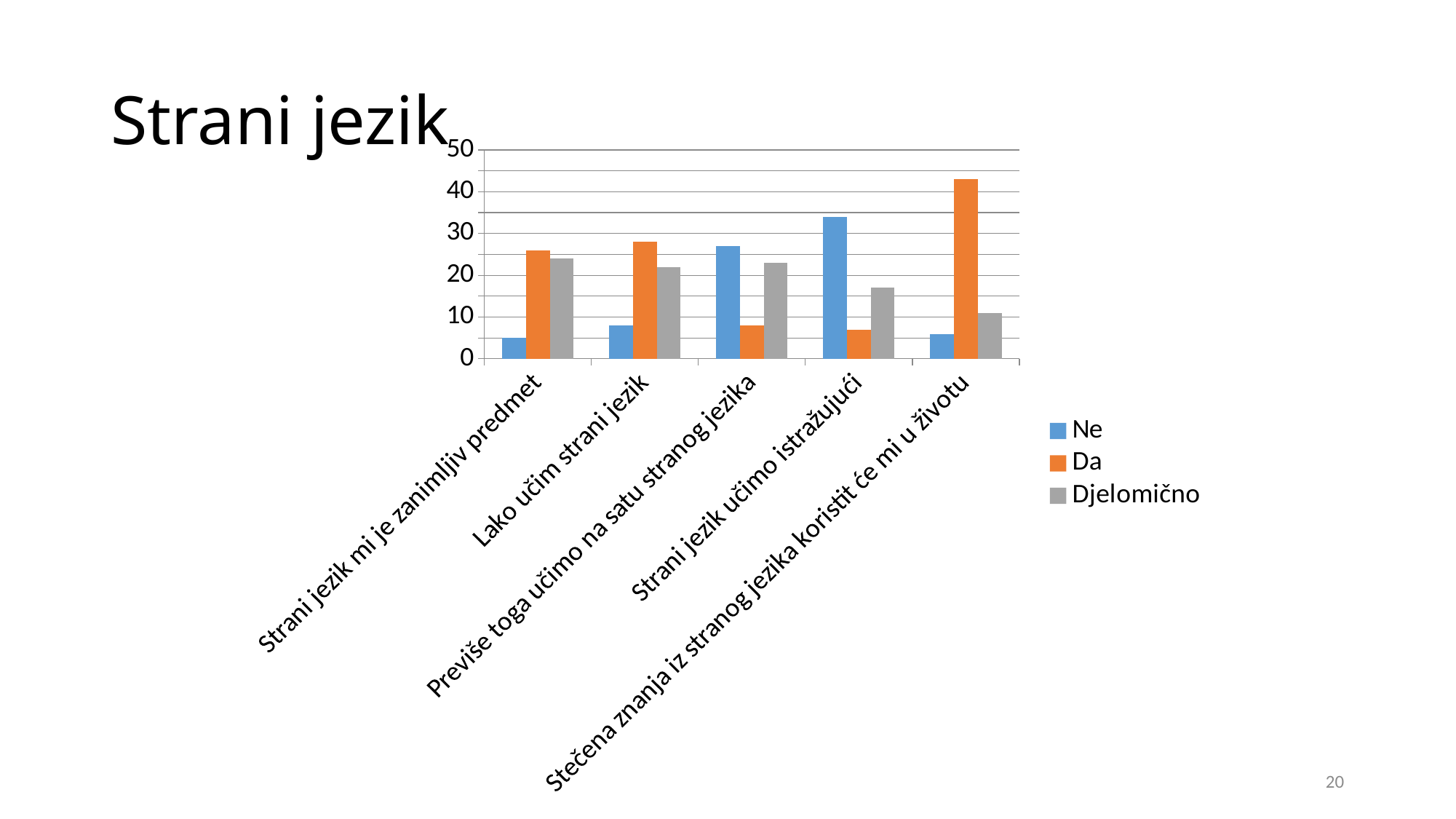
What colour are the "Da" bars in the chart? orange Which series has the highest bar for "Stečena znanja iz stranog jezika koristit će mi u životu"? Da Is the "Ne" value for "Strani jezik učimo istražujući" greater or less than 30? greater Is the "Ne" value for "Strani jezik mi je zanimljiv predmet" greater or less than 10? less How many series does the chart's legend list? 3 Is the "Da" value for "Stečena znanja iz stranog jezika koristit će mi u životu" greater or less than 40? greater How many categories are shown on the x axis of the chart? 5 What are the three legend entries of the chart? Ne, Da, Djelomično For "Previše toga učimo na satu stranog jezika", which is larger: the "Ne" value or the "Da" value? Ne Across all categories, which category has the highest "Ne" bar? Strani jezik učimo istražujući What kind of chart is shown on the slide? bar chart Which series has the lowest bar for "Strani jezik učimo istražujući"? Da